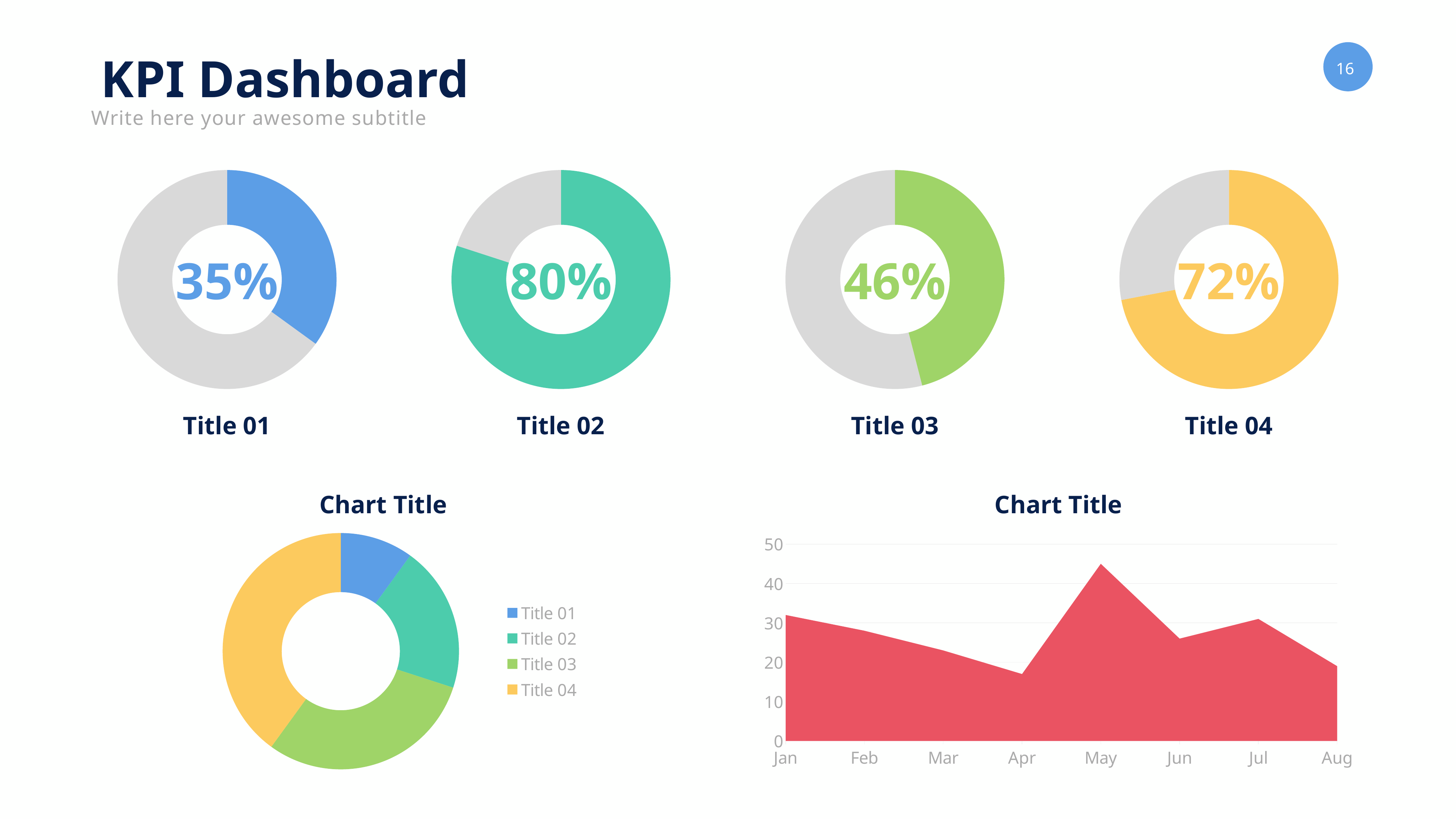
In the Title 01 gauge at the top of the slide, what percentage is shown? 35% In the bottom-right area chart, is the value for May greater or less than 40? greater Among the four KPI gauges at the top of the slide, which title has the lowest percentage? Title 01 Among the KPI gauges at the top of the slide, what is the difference between the Title 02 and Title 01 percentages? 45% In the bottom-right area chart, how many months are shown on the x axis? 8 Among the four KPI gauges at the top of the slide, which title has the highest percentage? Title 02 In the Title 02 gauge at the top of the slide, what percentage is shown? 80% In the donut chart at the bottom left of the slide, how many entries does the legend list? 4 In the donut chart at the bottom left of the slide, which legend entry has the largest slice? Title 04 What kind of chart is the bottom-right chart on the slide? Area chart Among the KPI gauges at the top of the slide, which is larger: the Title 03 value or the Title 04 value? Title 04 In the Title 04 gauge at the top of the slide, what percentage is shown? 72%